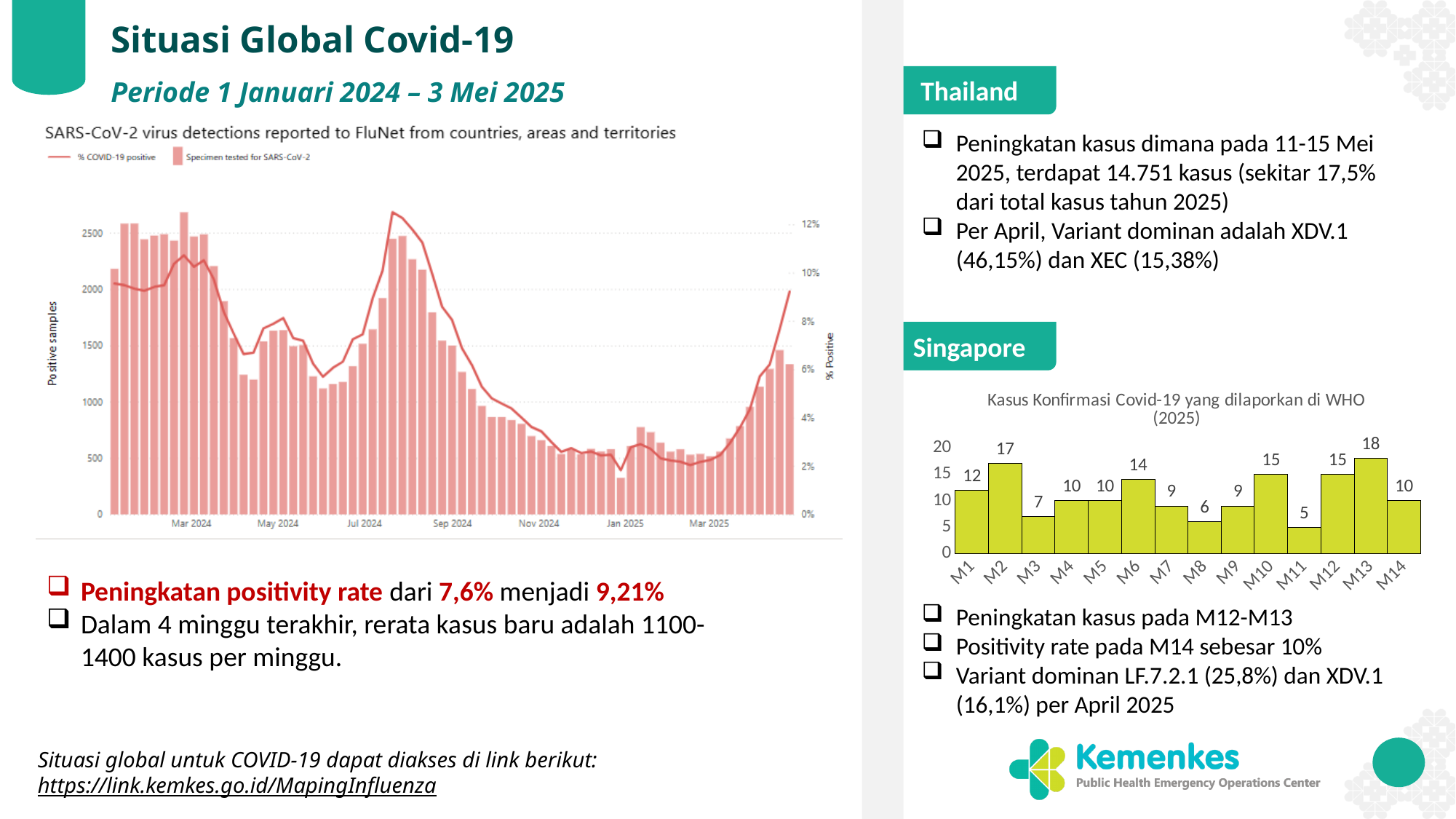
In the Singapore chart 'Kasus Konfirmasi Covid-19 yang dilaporkan di WHO (2025)', what is the value for M2? 17 In the Singapore chart 'Kasus Konfirmasi Covid-19 yang dilaporkan di WHO (2025)', how many weeks (categories) are shown on the x axis? 14 In the Singapore chart 'Kasus Konfirmasi Covid-19 yang dilaporkan di WHO (2025)', what is the total of the values for M12 and M13? 33 In the Singapore chart 'Kasus Konfirmasi Covid-19 yang dilaporkan di WHO (2025)', which week has the highest value? M13 In the Singapore chart 'Kasus Konfirmasi Covid-19 yang dilaporkan di WHO (2025)', what is the difference between the values for M13 and M14? 8 What kind of chart is the Singapore chart 'Kasus Konfirmasi Covid-19 yang dilaporkan di WHO (2025)'? Bar chart In the left chart 'SARS-CoV-2 virus detections reported to FluNet', what does the red line represent according to the legend? % COVID-19 positive In the Singapore chart 'Kasus Konfirmasi Covid-19 yang dilaporkan di WHO (2025)', which is larger, the value for M6 or the value for M7? M6 In the Singapore chart 'Kasus Konfirmasi Covid-19 yang dilaporkan di WHO (2025)', which week has the lowest value? M11 In the left chart 'SARS-CoV-2 virus detections reported to FluNet', is the number of positive samples in the bar at Jan 2025 greater or less than 1000? less In the Singapore chart 'Kasus Konfirmasi Covid-19 yang dilaporkan di WHO (2025)', what is the value for M13? 18 In the left chart 'SARS-CoV-2 virus detections reported to FluNet', how many series does the legend list? 2